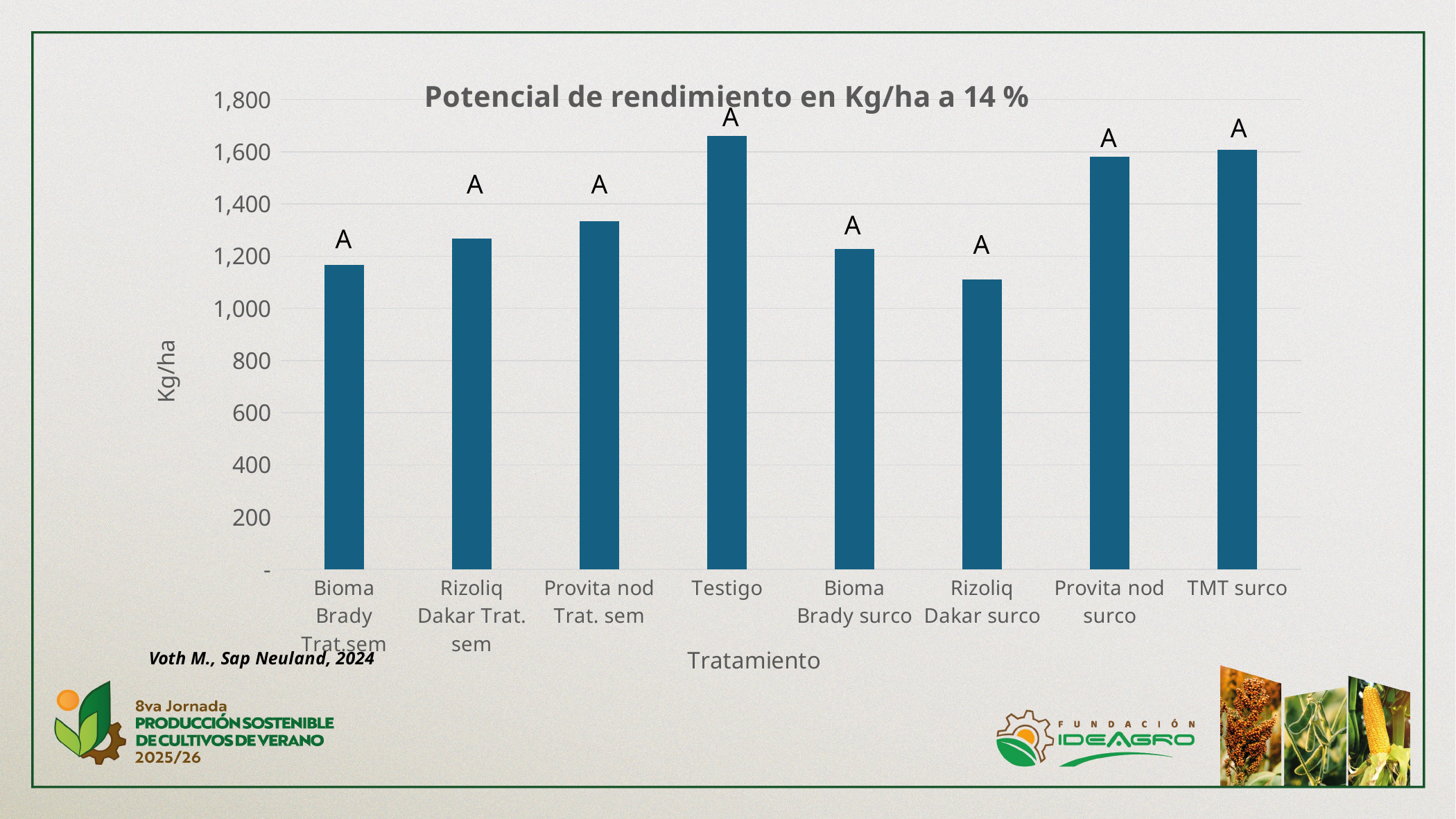
Which is larger, the value for Provita nod surco or the value for Provita nod Trat. sem? Provita nod surco What type of chart is shown on the slide? bar chart Is the value for Provita nod Trat. sem greater or less than 1,400? less How many treatments (bars) are plotted in the chart? 8 Is the value for Rizoliq Dakar Trat. sem greater or less than 1,200? greater Is the value for Bioma Brady Trat.sem greater or less than 1,200? less Which treatment has the highest yield potential? Testigo What is the title of the chart? Potencial de rendimiento en Kg/ha a 14 % Which treatment has the lowest yield potential? Rizoliq Dakar surco What is the label on the vertical axis of the chart? Kg/ha